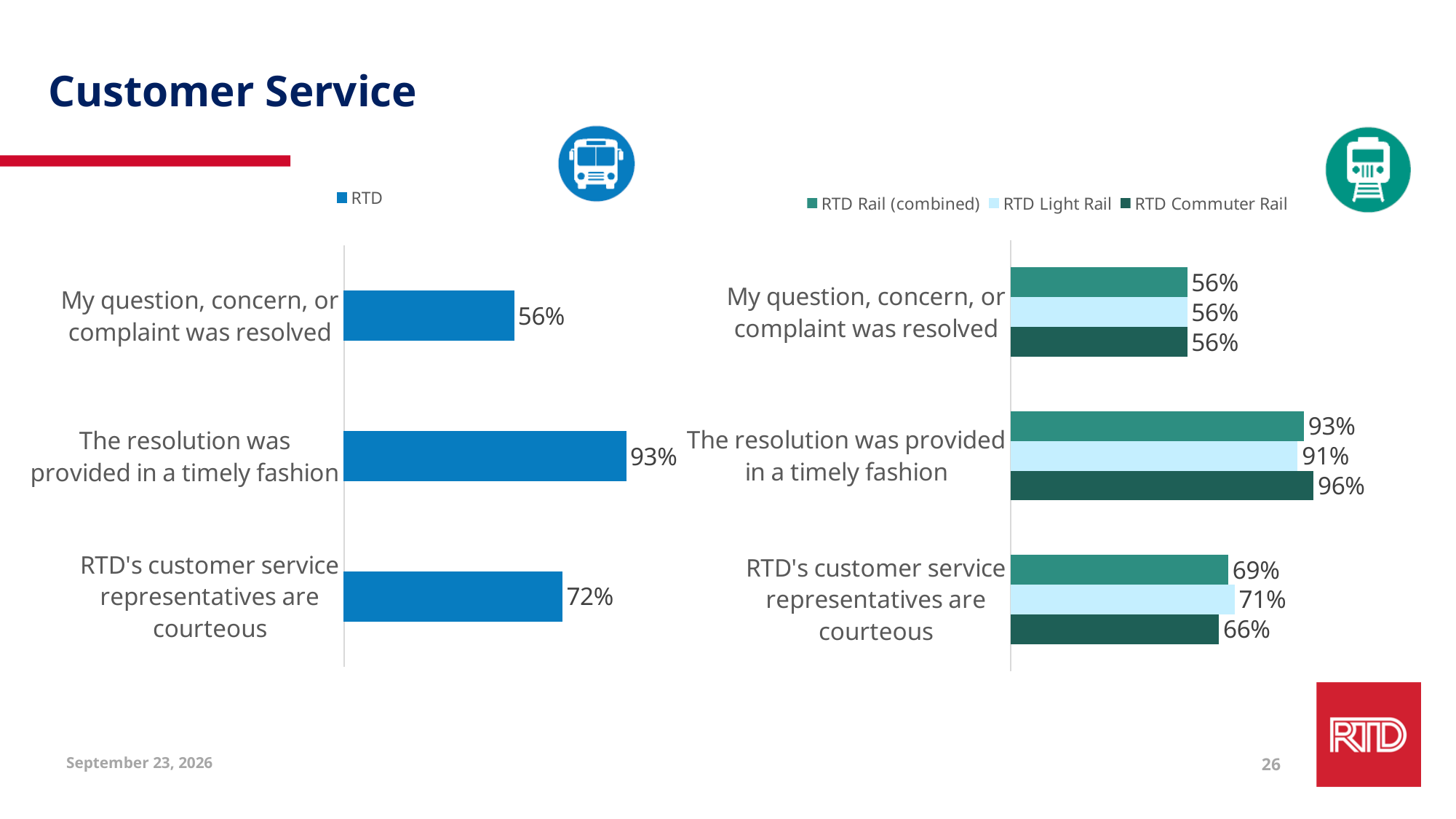
In the right chart (rail), what is the RTD Rail (combined) value for 'My question, concern, or complaint was resolved'? 56% In the left chart (bus, RTD), what is the difference between 'The resolution was provided in a timely fashion' and 'My question, concern, or complaint was resolved'? 37% In the right chart (rail), what is the RTD Light Rail value for 'RTD's customer service representatives are courteous'? 71% In the right chart (rail), how many series does the legend list? 3 In the right chart (rail), which is larger for 'RTD's customer service representatives are courteous': RTD Light Rail or RTD Commuter Rail? RTD Light Rail What kind of chart is the left chart (bus, RTD)? Bar chart In the right chart (rail), what is the difference between the RTD Commuter Rail and RTD Light Rail values for 'The resolution was provided in a timely fashion'? 5% In the left chart (bus, RTD), what is the value for 'RTD's customer service representatives are courteous'? 72% In the right chart (rail), what is the RTD Commuter Rail value for 'The resolution was provided in a timely fashion'? 96% How many categories are shown in the left chart (bus, RTD)? 3 In the left chart (bus, RTD), which category has the lowest value? My question, concern, or complaint was resolved In the left chart (bus, RTD), what is the value for 'The resolution was provided in a timely fashion'? 93%